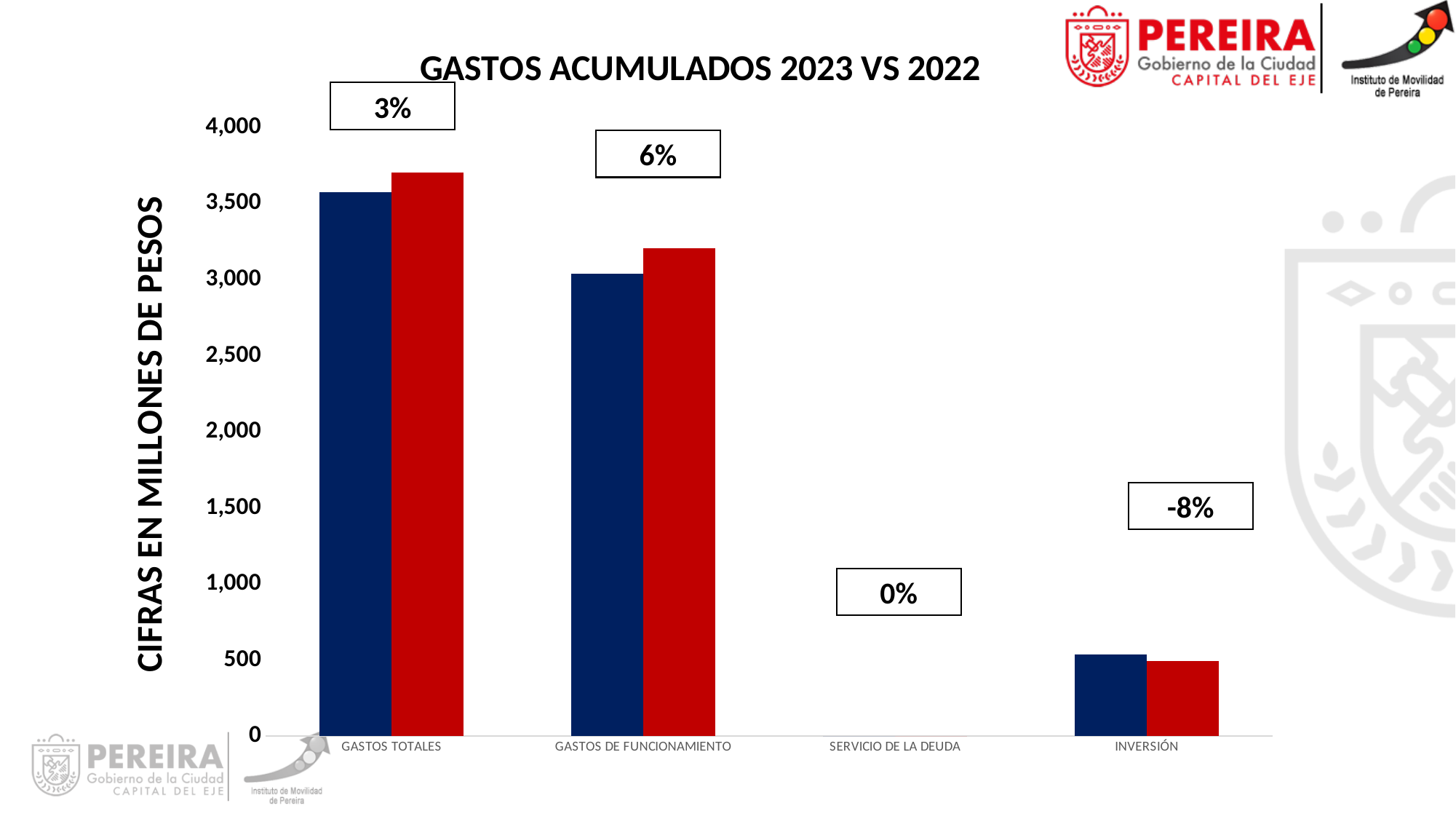
What percentage label is shown for SERVICIO DE LA DEUDA? 0% What percentage label is shown above the GASTOS TOTALES bars? 3% Which category has the lowest values in the chart? SERVICIO DE LA DEUDA What is the label of the vertical axis? CIFRAS EN MILLONES DE PESOS Which category has the tallest bars in the chart? GASTOS TOTALES What is the title of the chart? GASTOS ACUMULADOS 2023 VS 2022 Is the blue bar for INVERSIÓN greater or less than 1,000? less What type of chart is shown on the slide? bar chart What percentage label is shown above the GASTOS DE FUNCIONAMIENTO bars? 6% Is the red bar for GASTOS DE FUNCIONAMIENTO greater or less than 3,000? greater How many categories are shown on the x axis of the chart? 4 What percentage label is shown above the INVERSIÓN bars? -8%